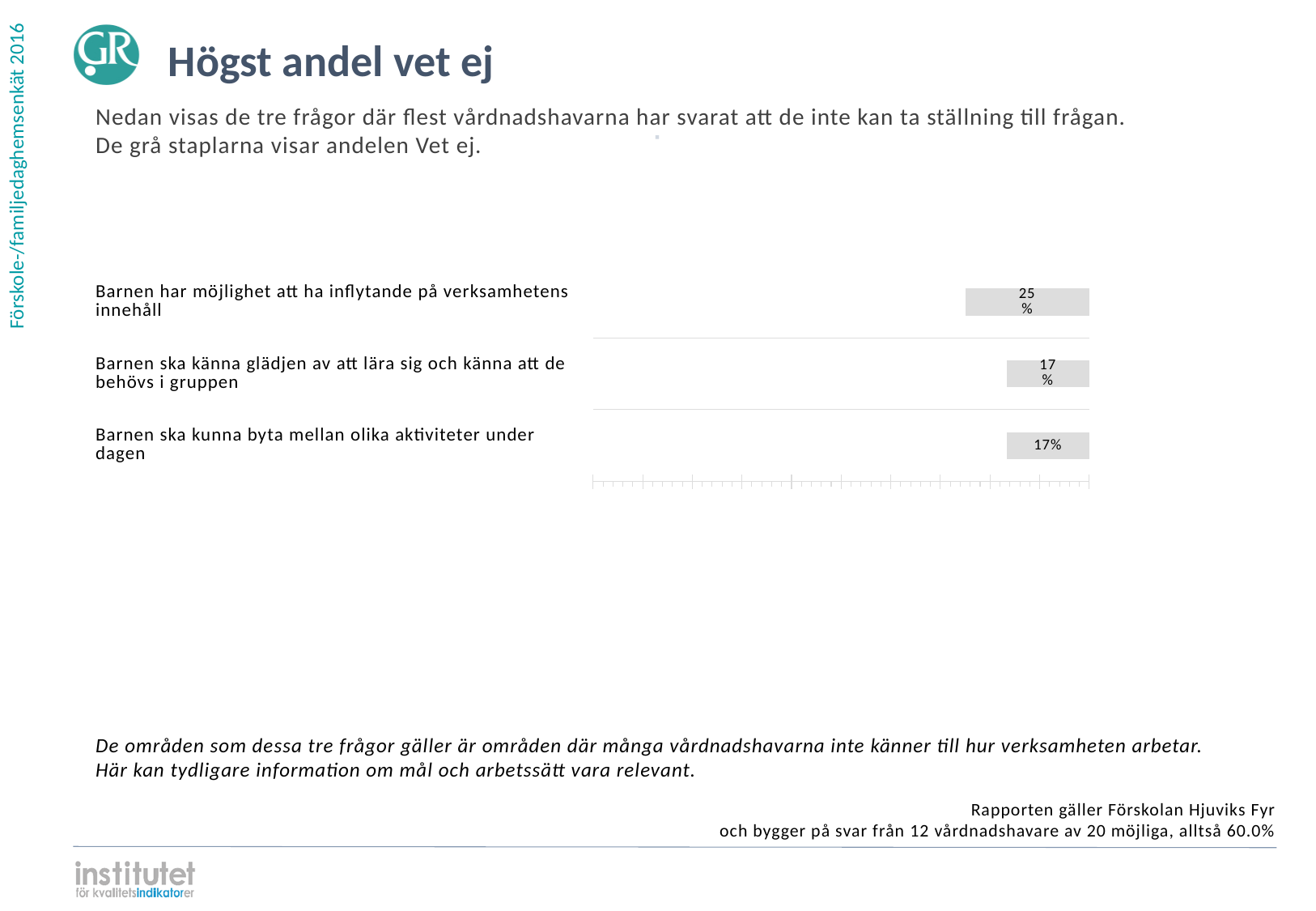
What is the value for "Barnen ska känna glädjen av att lära sig och känna att de behövs i gruppen"? 17% What is the title of the slide containing the chart? Högst andel vet ej What is the value for "Barnen ska kunna byta mellan olika aktiviteter under dagen"? 17% Which is larger: the value for "Barnen har möjlighet att ha inflytande på verksamhetens innehåll" or the value for "Barnen ska känna glädjen av att lära sig och känna att de behövs i gruppen"? Barnen har möjlighet att ha inflytande på verksamhetens innehåll How many categories are shown in the chart? 3 What is the difference between the value for "Barnen har möjlighet att ha inflytande på verksamhetens innehåll" and the value for "Barnen ska kunna byta mellan olika aktiviteter under dagen"? 8% What colour are the bars in the chart? Grey What kind of chart is shown on the slide? Bar chart What is the value for "Barnen har möjlighet att ha inflytande på verksamhetens innehåll"? 25% Which category has the highest value? Barnen har möjlighet att ha inflytande på verksamhetens innehåll